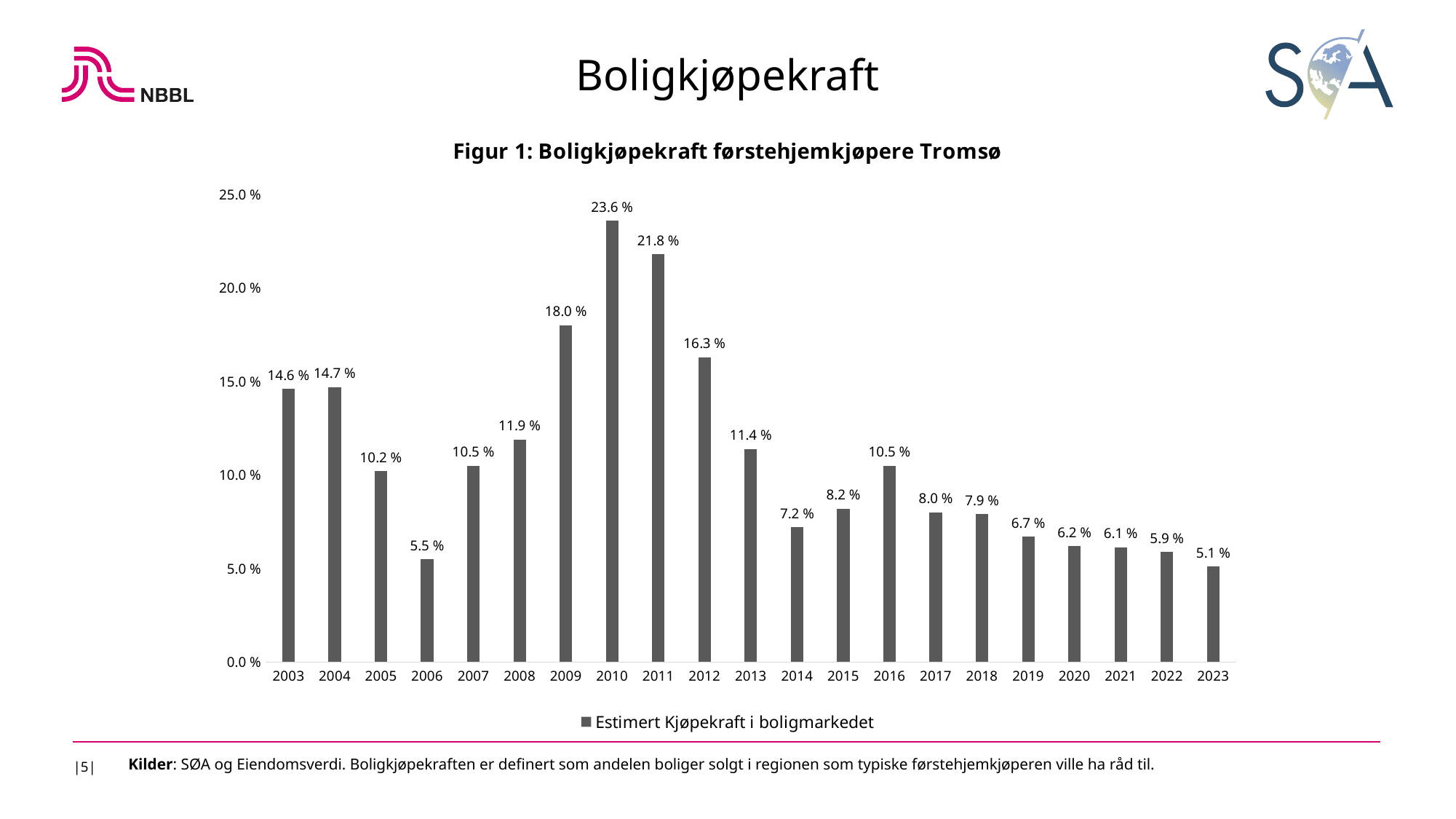
Which year has the lowest value? 2023 Which is larger, the value for 2009 or the value for 2012? 2009 How many series does the legend list? 1 What is the difference between the values for 2010 and 2011? 1.8 % Which year has the highest value? 2010 What is the value for 2010? 23.6 % What kind of chart is shown? bar chart Is the value for 2008 greater or less than 10.0 %? greater What is the value for 2023? 5.1 % How many years are shown on the x axis? 21 What is the value for 2006? 5.5 % Do the values rise or fall from 2016 to 2023? fall